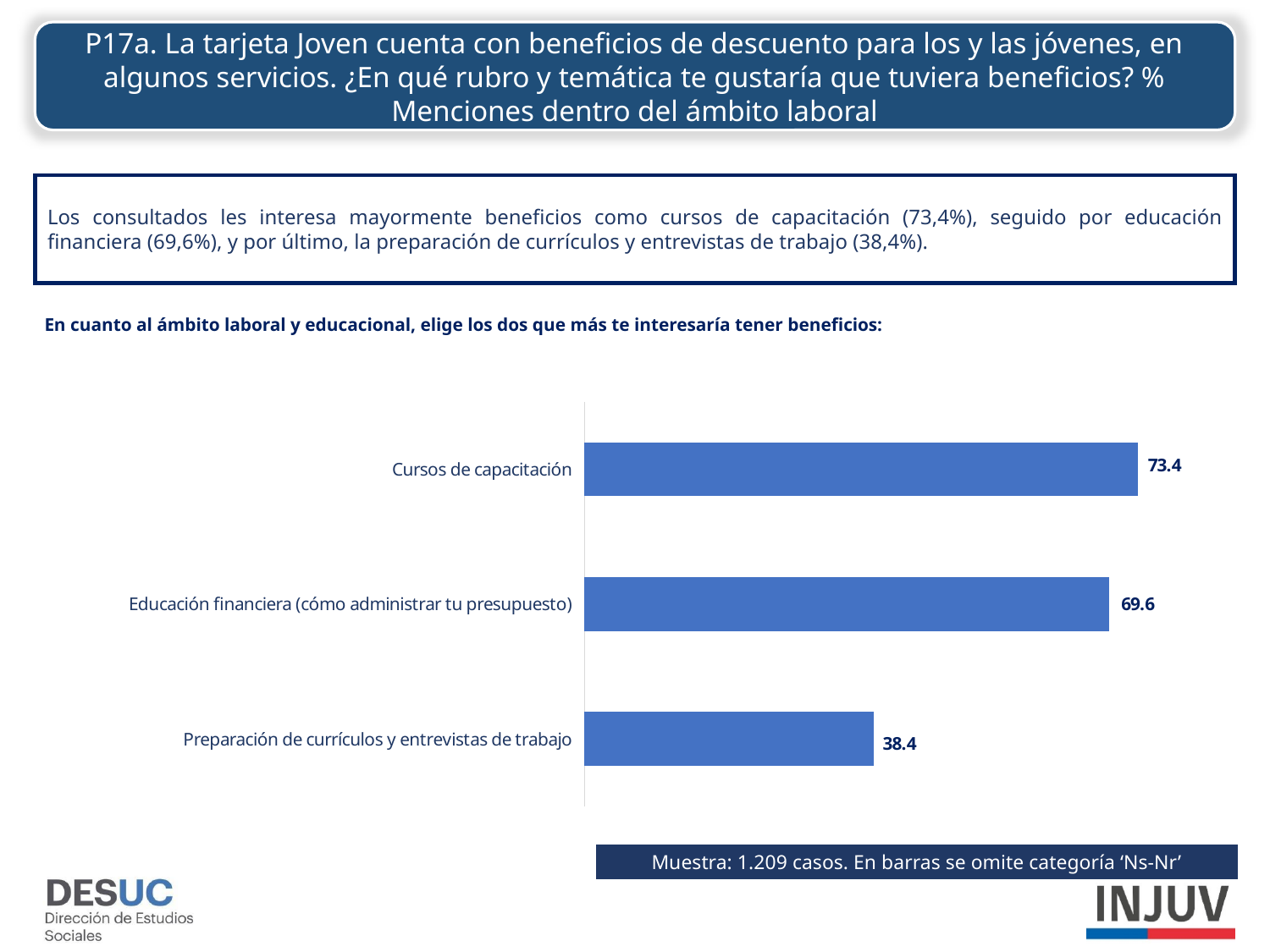
What kind of chart is shown on the slide? Bar chart What is the value for Cursos de capacitación? 73.4 How many categories are shown in the chart? 3 What is the value for Educación financiera (cómo administrar tu presupuesto)? 69.6 What is the difference between the values for Cursos de capacitación and Educación financiera (cómo administrar tu presupuesto)? 3.8 Which category has the highest value? Cursos de capacitación What is the sample size stated on the slide? 1.209 casos Which category is omitted from the bars according to the note on the slide? Ns-Nr What is the difference between the values for Educación financiera (cómo administrar tu presupuesto) and Preparación de currículos y entrevistas de trabajo? 31.2 Which category has the lowest value? Preparación de currículos y entrevistas de trabajo Which is larger: the value for Educación financiera (cómo administrar tu presupuesto) or the value for Preparación de currículos y entrevistas de trabajo? Educación financiera (cómo administrar tu presupuesto) What is the value for Preparación de currículos y entrevistas de trabajo? 38.4